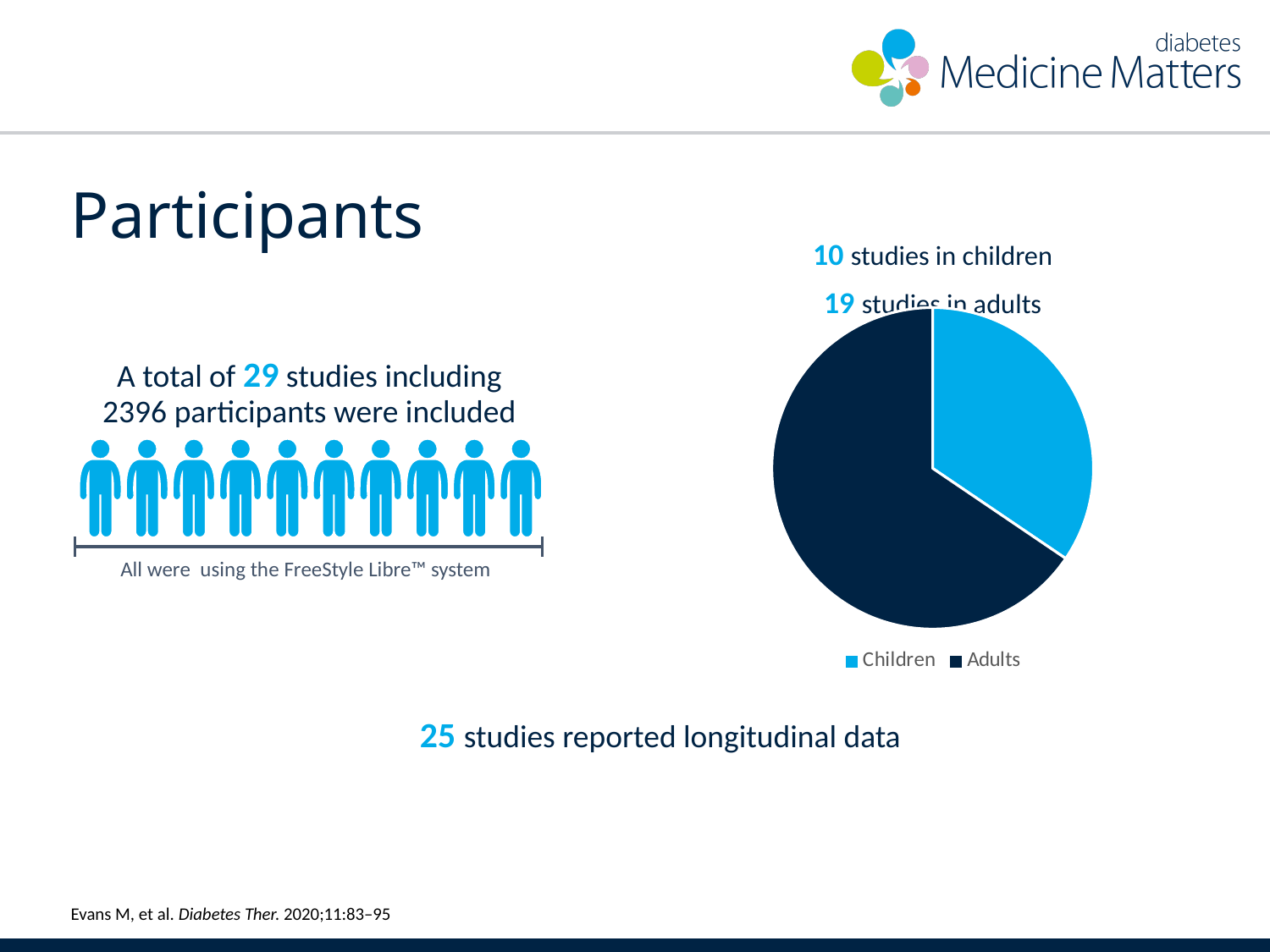
Which category has the largest slice in the pie chart? Adults What kind of chart is shown on the slide? Pie chart Which colour represents Adults in the pie chart? Dark navy blue Which category has the smallest slice in the pie chart? Children What is the difference between the number of studies in adults and the number of studies in children? 9 How many studies in children does the pie chart represent? 10 Which slice of the pie chart is larger, Children or Adults? Adults What are the two categories listed in the pie chart legend? Children and Adults How many studies in adults does the pie chart represent? 19 How many slices does the pie chart have? 2 What is the total number of studies represented by the two slices of the pie chart? 29 How many entries does the pie chart legend list? 2